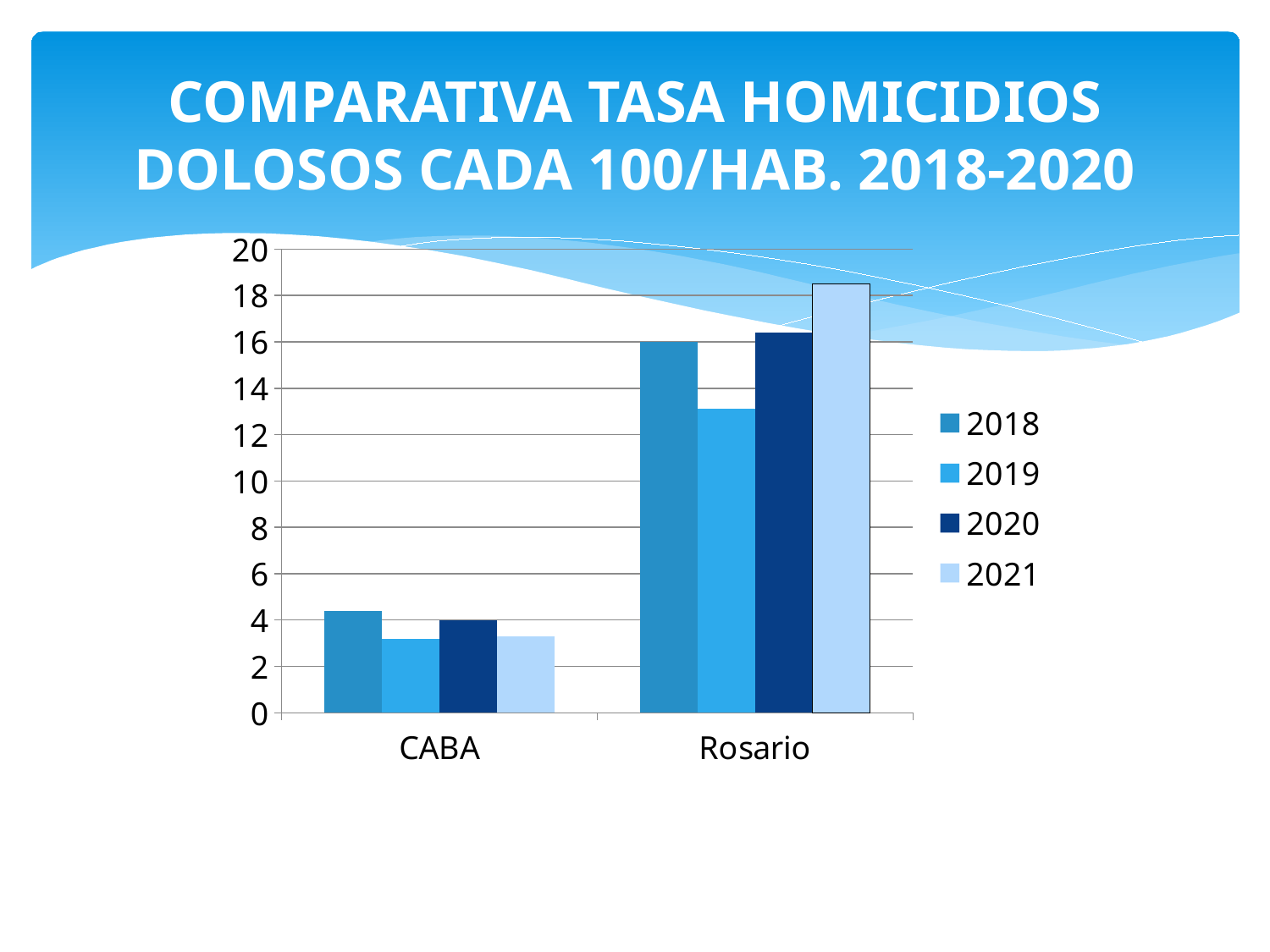
Is the value for Rosario in 2020 greater or less than 18? less How many series does the legend list? 4 Is the value for Rosario in 2021 greater or less than 18? greater Which year has the highest value for CABA? 2018 Is the value for CABA in 2019 greater or less than 4? less Which is larger: the 2018 value for CABA or the 2018 value for Rosario? Rosario How many categories are shown on the x axis? 2 What kind of chart is shown on the slide? bar chart Which year has the highest value for Rosario? 2021 Which year has the lowest value for Rosario? 2019 What is the title of the slide? COMPARATIVA TASA HOMICIDIOS DOLOSOS CADA 100/HAB. 2018-2020